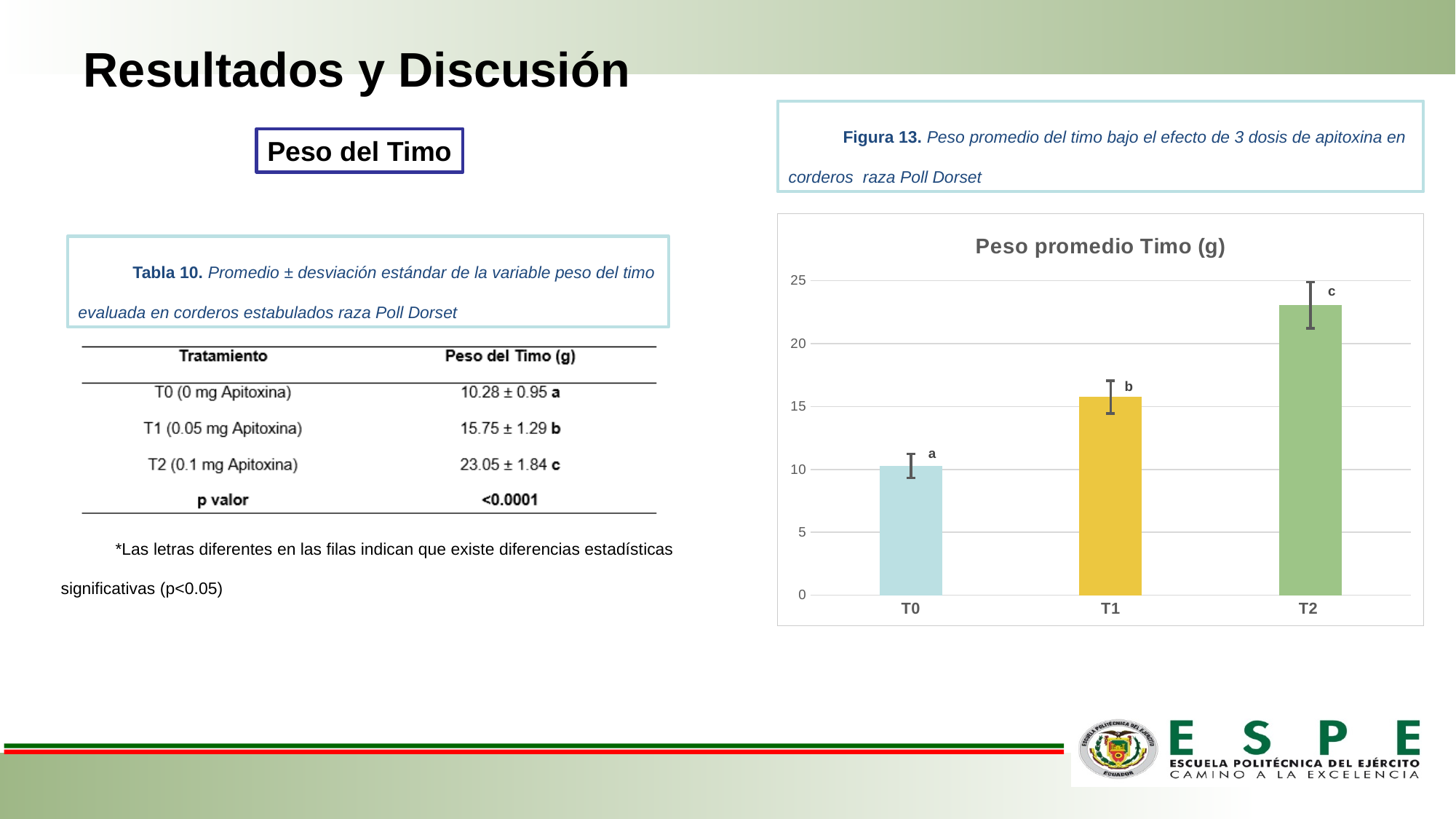
What letter label is placed above the T1 bar in the chart? b Is the bar for T2 greater or less than 20? greater What type of chart is shown on the slide? bar chart Is the bar for T0 greater or less than 15? less What is the title of the chart? Peso promedio Timo (g) According to the table on the slide, what is the average thymus weight (Peso del Timo) for T2? 23.05 Is the bar for T1 greater or less than 15? greater Which treatment has the highest bar in the chart? T2 Do the bar values rise or fall from T0 to T2 along the x axis? rise Which bar is taller, T1 or T0? T1 How many treatment categories are plotted on the x axis of the chart? 3 Which treatment has the lowest bar in the chart? T0